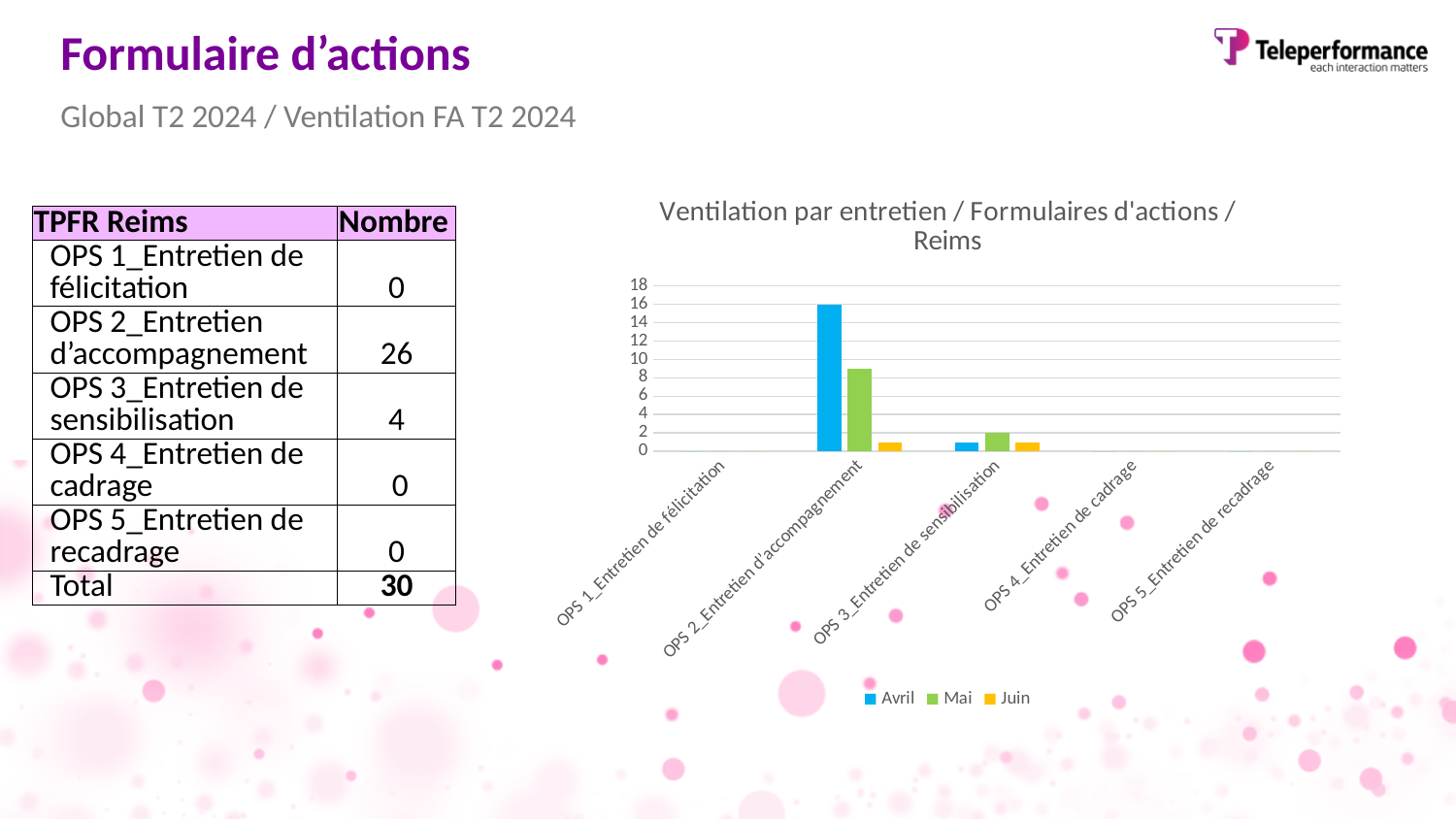
What is the title of the chart? Ventilation par entretien / Formulaires d'actions / Reims What kind of chart is shown on the slide? bar chart How many categories are shown on the x axis of the chart? 5 Is the Avril value for OPS 2_Entretien d'accompagnement greater or less than 10? greater What are the legend entries of the chart? Avril, Mai, Juin Which category has the highest Avril value in the chart? OPS 2_Entretien d'accompagnement For OPS 2_Entretien d'accompagnement, which is larger: the Avril value or the Mai value? Avril Is the Mai value for OPS 2_Entretien d'accompagnement greater or less than 6? greater Is the Mai value for OPS 2_Entretien d'accompagnement greater or less than 10? less What is the Avril value for OPS 2_Entretien d'accompagnement? 16 For OPS 3_Entretien de sensibilisation, which is larger: the Mai value or the Avril value? Mai How many series does the legend of the chart list? 3